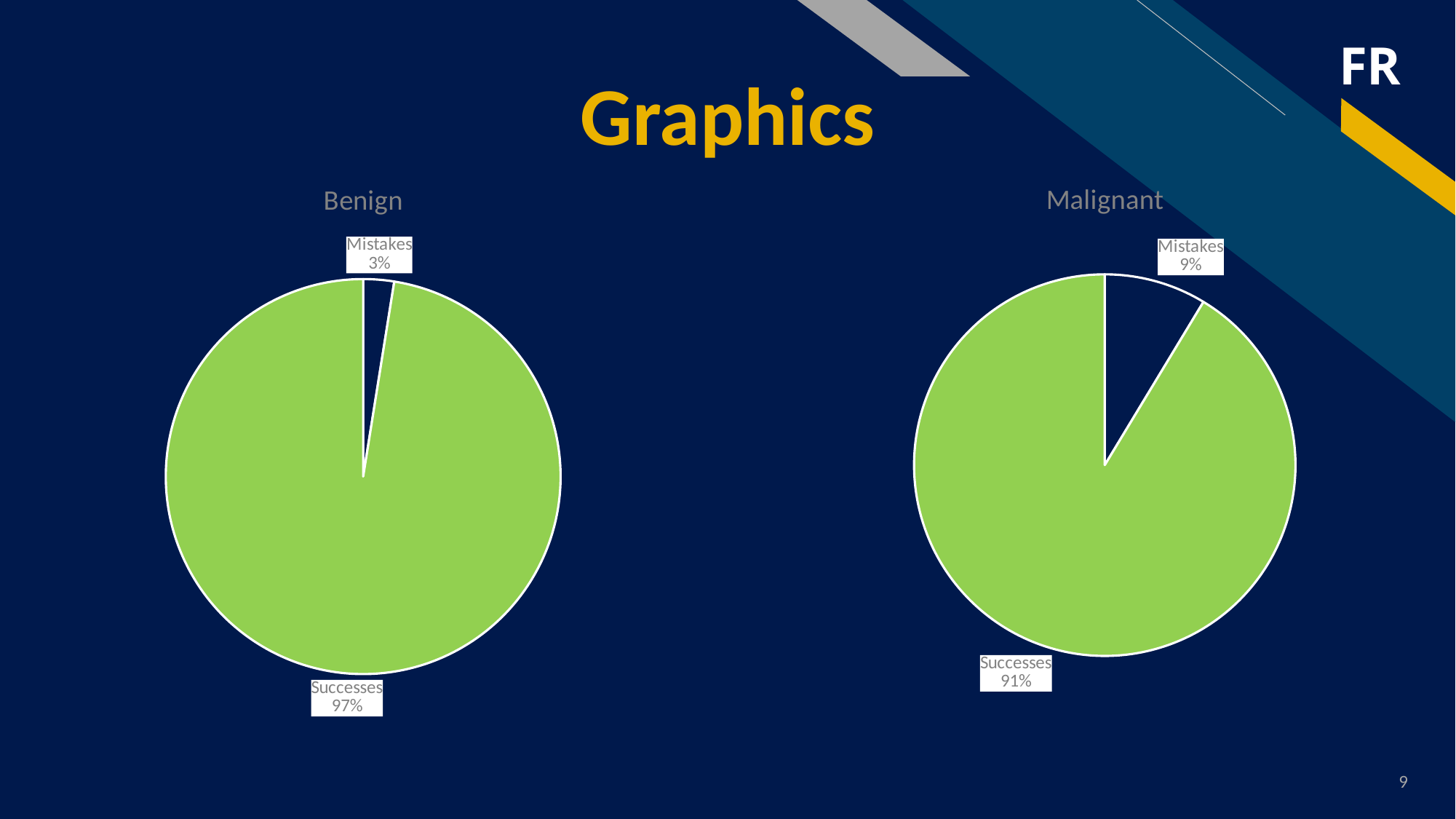
In the Malignant chart, which slice is the smallest? Mistakes How many slices does the Malignant chart have? 2 In the Benign chart, which slice is the largest? Successes In the Benign chart, what is the difference between the Successes share and the Mistakes share? 94% In the Malignant chart, what share of the pie is Mistakes? 9% In the Benign chart, what share of the pie is Mistakes? 3% What is the difference between the Mistakes share in the Malignant chart and the Mistakes share in the Benign chart? 6% What kind of chart is the Benign chart? Pie chart In the Malignant chart, what share of the pie is Successes? 91% What is the title of the chart on the right side of the slide? Malignant Which chart has the larger Mistakes share, Benign or Malignant? Malignant